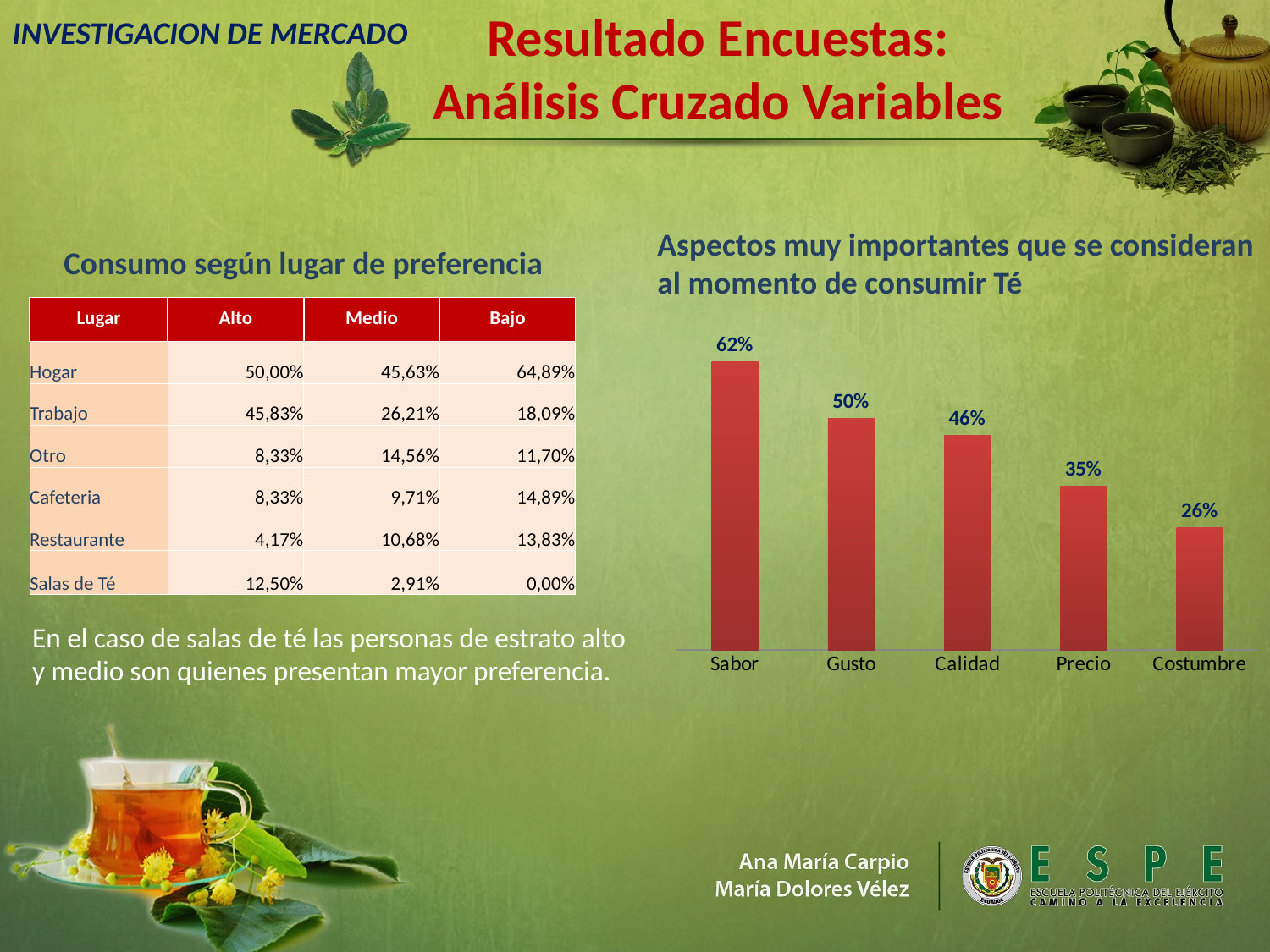
What is the difference between the values for Sabor and Gusto in the bar chart? 12% Which is larger in the bar chart, Gusto or Calidad? Gusto What kind of chart is shown on the slide? Bar chart What is the value for Sabor in the bar chart? 62% How many categories are shown in the bar chart? 5 Do the values in the bar chart rise or fall from Sabor to Costumbre? Fall What is the title of the bar chart? Aspectos muy importantes que se consideran al momento de consumir Té What is the value for Precio in the bar chart? 35% Which category has the highest value in the bar chart? Sabor What is the difference between the values for Calidad and Costumbre in the bar chart? 20% Which category has the lowest value in the bar chart? Costumbre What is the value for Costumbre in the bar chart? 26%